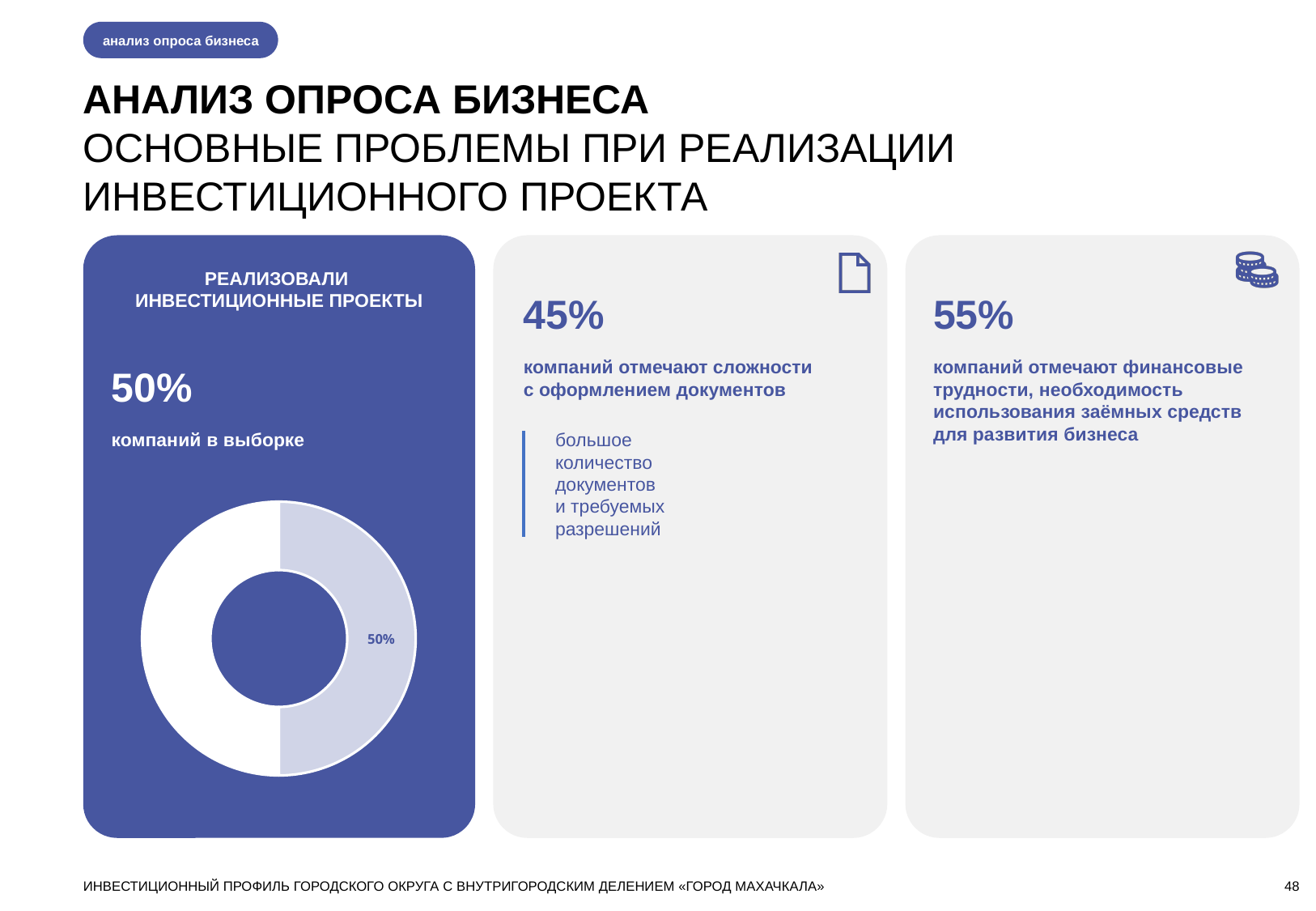
What share of the donut chart does the labelled (light) slice represent? 50% What is the heading of the panel containing the donut chart? РЕАЛИЗОВАЛИ ИНВЕСТИЦИОННЫЕ ПРОЕКТЫ What kind of chart is shown on the slide? Pie (donut) chart How many slices does the donut chart have? 2 What value is printed on the labelled slice of the donut chart? 50% What colour is the labelled 50% slice of the donut chart? Light lavender (pale blue-grey) Is the labelled slice of the donut chart greater or less than 25%? greater Is the labelled slice of the donut chart greater or less than 75%? less